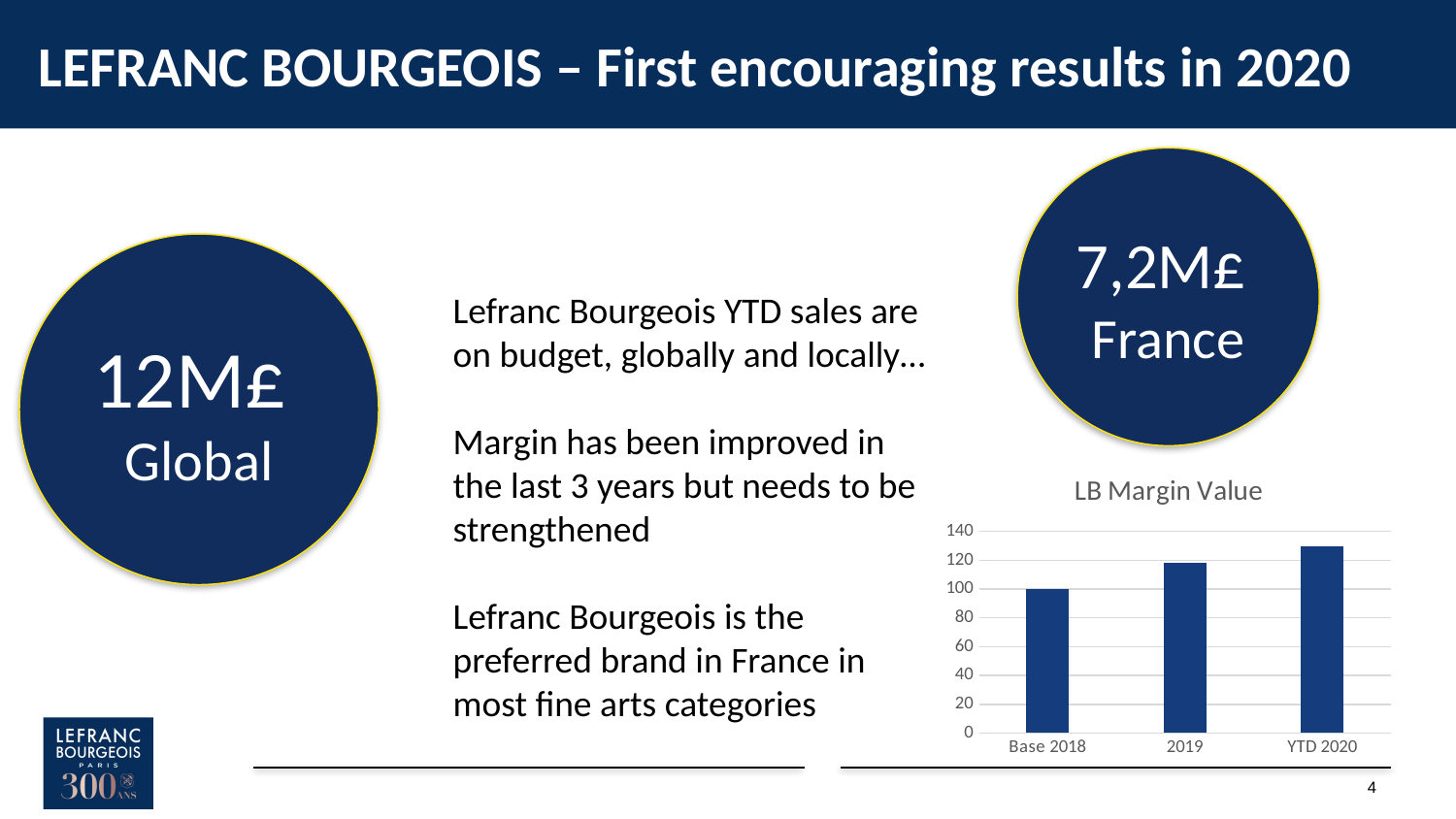
Which category has the highest value in the LB Margin Value chart? YTD 2020 What is the title of the chart? LB Margin Value What is the value for Base 2018 in the LB Margin Value chart? 100 Which is larger in the LB Margin Value chart, the value for 2019 or the value for Base 2018? 2019 Which category has the lowest value in the LB Margin Value chart? Base 2018 Is the value for 2019 greater or less than 100? greater What is the highest tick shown on the vertical axis of the LB Margin Value chart? 140 How many categories are plotted in the LB Margin Value chart? 3 Is the value for YTD 2020 greater or less than 120? greater What kind of chart is shown on the slide? bar chart Is the value for YTD 2020 greater or less than 140? less Do the values in the LB Margin Value chart rise or fall from Base 2018 to YTD 2020? rise